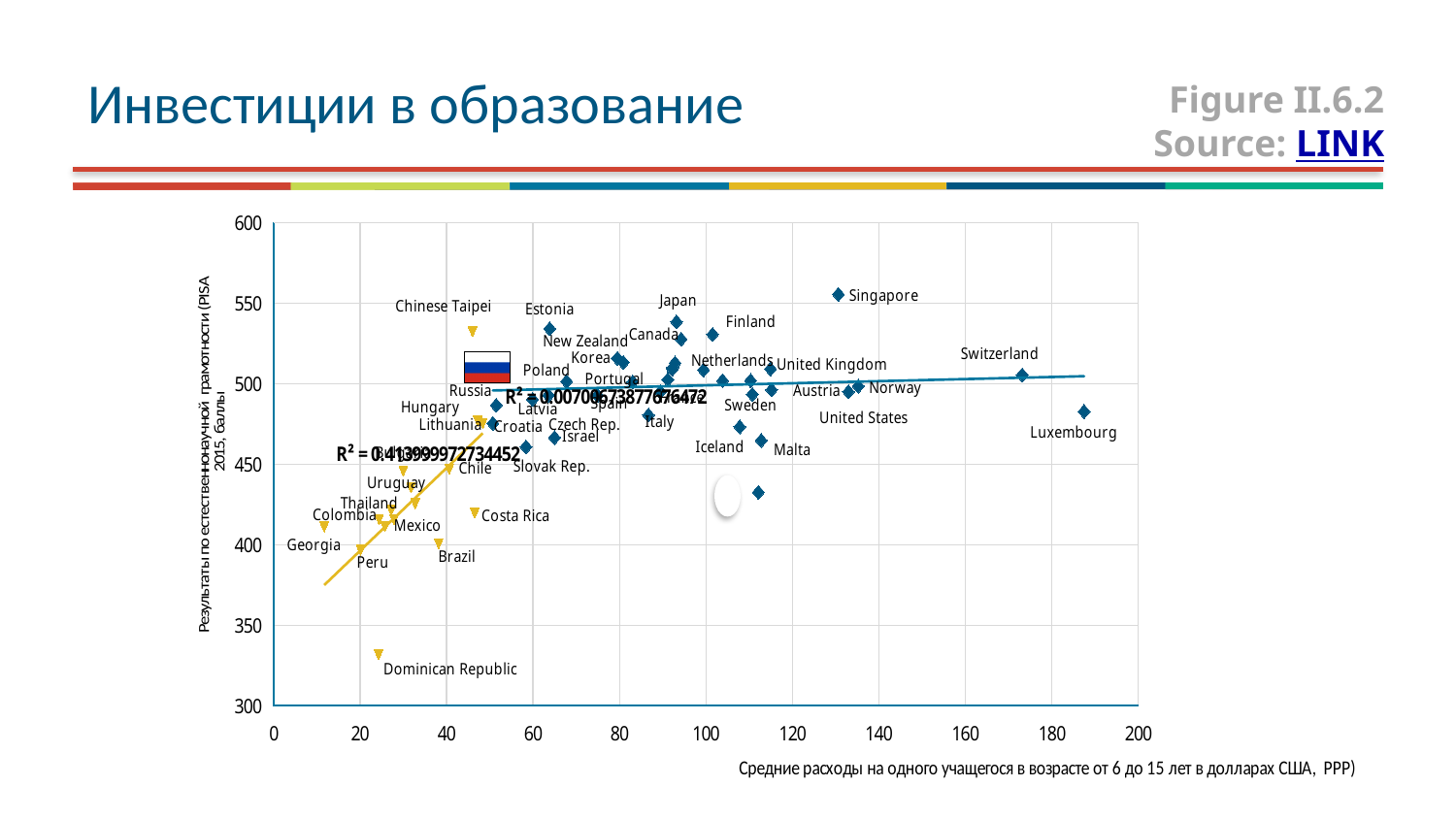
Which has the higher spending per student, Switzerland or Luxembourg? Luxembourg Is the spending value for Luxembourg greater or less than 160? greater Is the spending value for Georgia greater or less than 20? less Which country has the lowest PISA science score on the chart? Dominican Republic Is the PISA score for Brazil greater or less than 450? less Which has the higher PISA score, Singapore or Luxembourg? Singapore What is the figure number shown in the top right of the slide? Figure II.6.2 Which country has the highest average spending per student (furthest right on the x axis)? Luxembourg What kind of chart is shown on the slide? scatter chart Which country has the highest PISA science score on the chart? Singapore